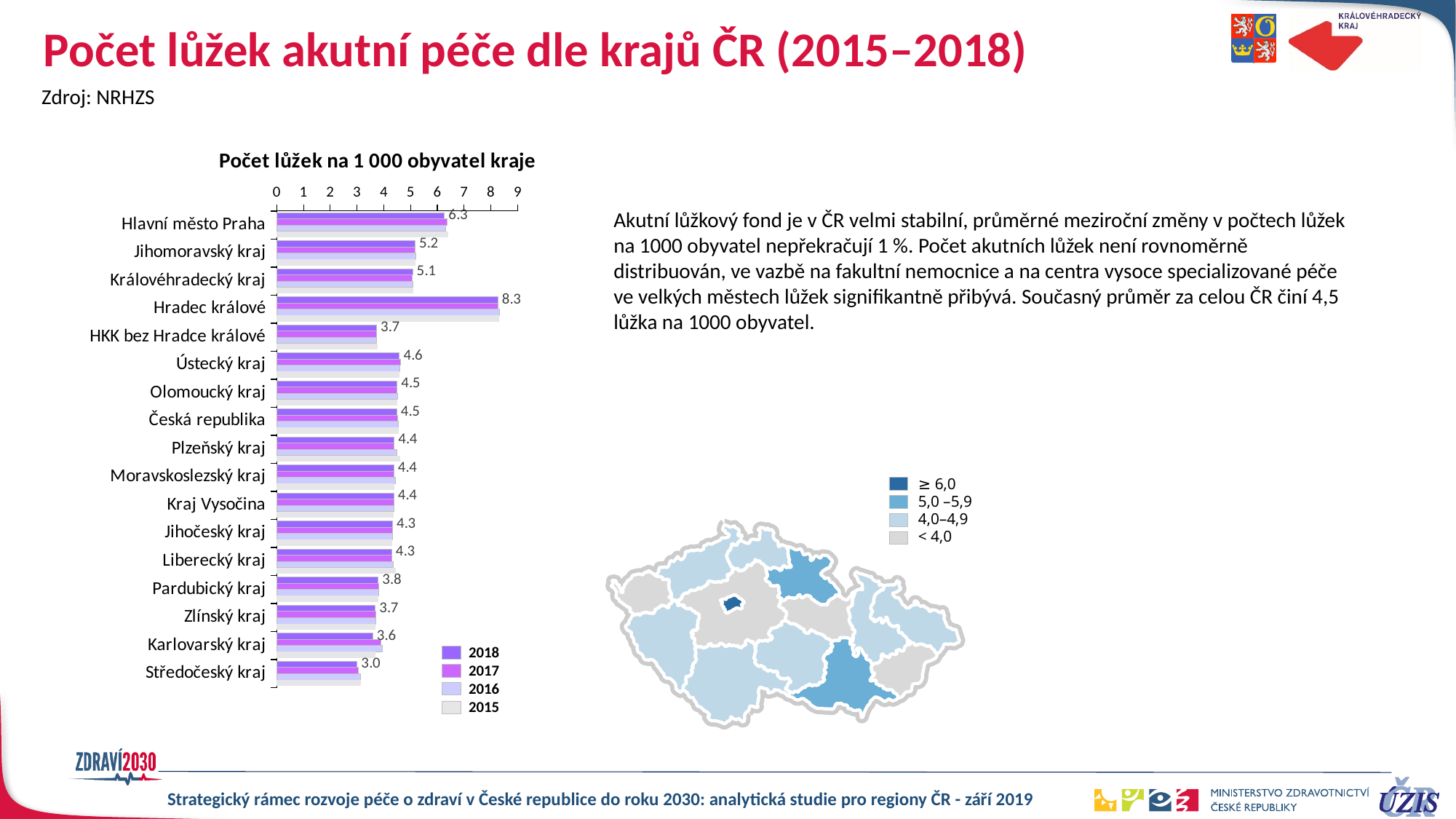
Which category has the lowest labelled value in the bar chart? Středočeský kraj How many series does the legend of the bar chart list? 4 What value is labelled for Středočeský kraj in the bar chart? 3.0 Is the labelled value for Pardubický kraj greater or less than 4? less What value is labelled for Česká republika in the bar chart? 4.5 Which category has the highest labelled value in the bar chart? Hradec králové Which has a larger labelled value in the bar chart, Jihomoravský kraj or Královéhradecký kraj? Jihomoravský kraj How many categories are shown on the vertical axis of the bar chart? 17 What type of chart is 'Počet lůžek na 1 000 obyvatel kraje'? bar chart What is the difference between the labelled values for Hradec králové and HKK bez Hradce králové? 4.6 What value is labelled for Hradec králové in the chart 'Počet lůžek na 1 000 obyvatel kraje'? 8.3 What value is labelled for Hlavní město Praha in the bar chart? 6.3